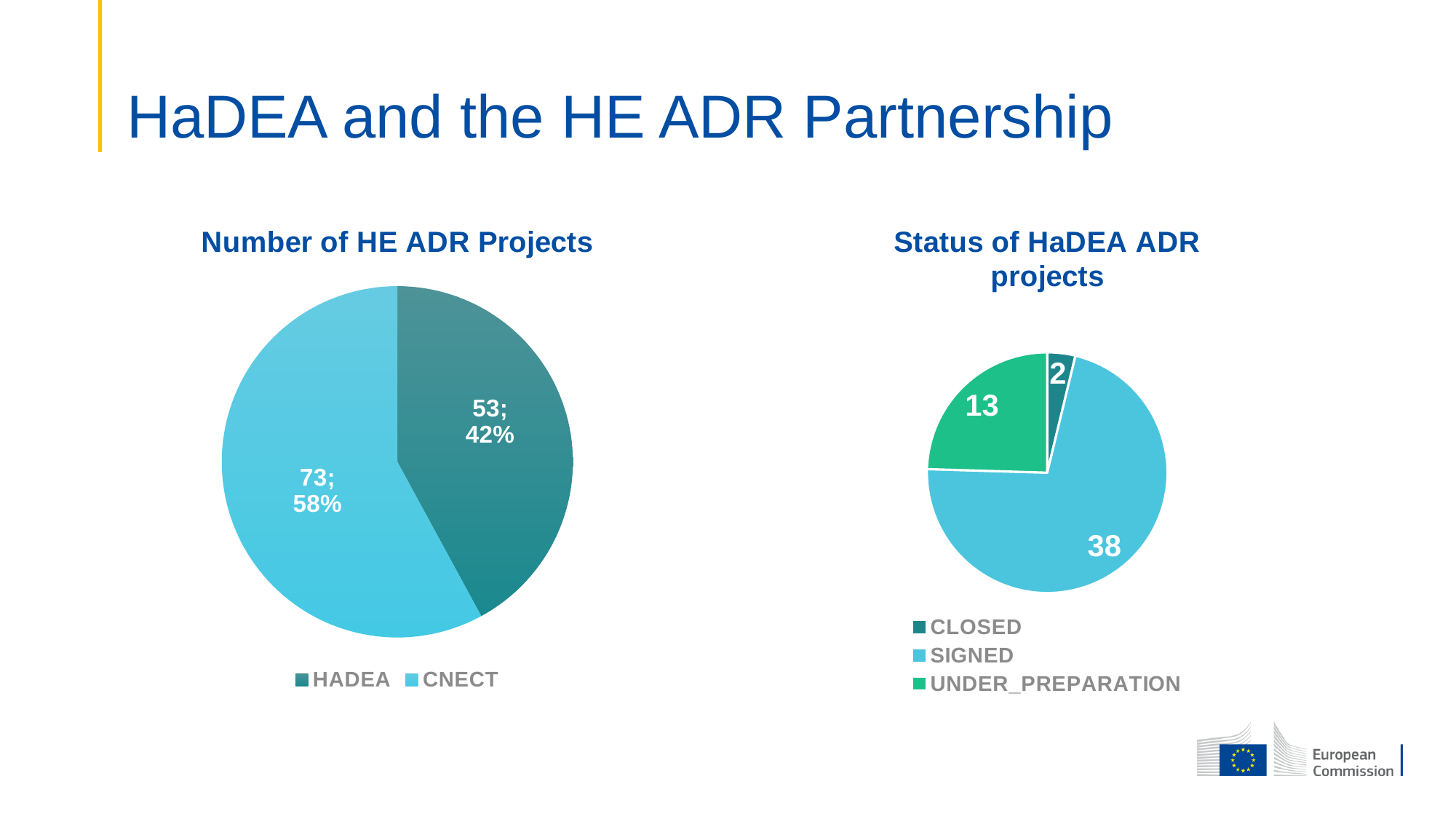
In the 'Number of HE ADR Projects' chart, which category has the larger number of projects? CNECT In the 'Number of HE ADR Projects' chart, what is the difference between the CNECT and HADEA project counts? 20 In the 'Status of HaDEA ADR projects' chart, how many projects are SIGNED? 38 In the 'Status of HaDEA ADR projects' chart, is the number of SIGNED projects larger than the number of UNDER_PREPARATION projects? Yes In the 'Status of HaDEA ADR projects' chart, what is the total number of projects across all statuses? 53 In the 'Number of HE ADR Projects' chart, what percentage share does CNECT have? 58% In the 'Status of HaDEA ADR projects' chart, how many status categories are shown in the legend? 3 In the 'Number of HE ADR Projects' chart, how many projects does HADEA have? 53 In the 'Status of HaDEA ADR projects' chart, how many projects are UNDER_PREPARATION? 13 What kind of chart is 'Number of HE ADR Projects'? Pie chart In the 'Number of HE ADR Projects' chart, which legend entry is shown in the darker teal colour? HADEA In the 'Status of HaDEA ADR projects' chart, which status has the smallest number of projects? CLOSED